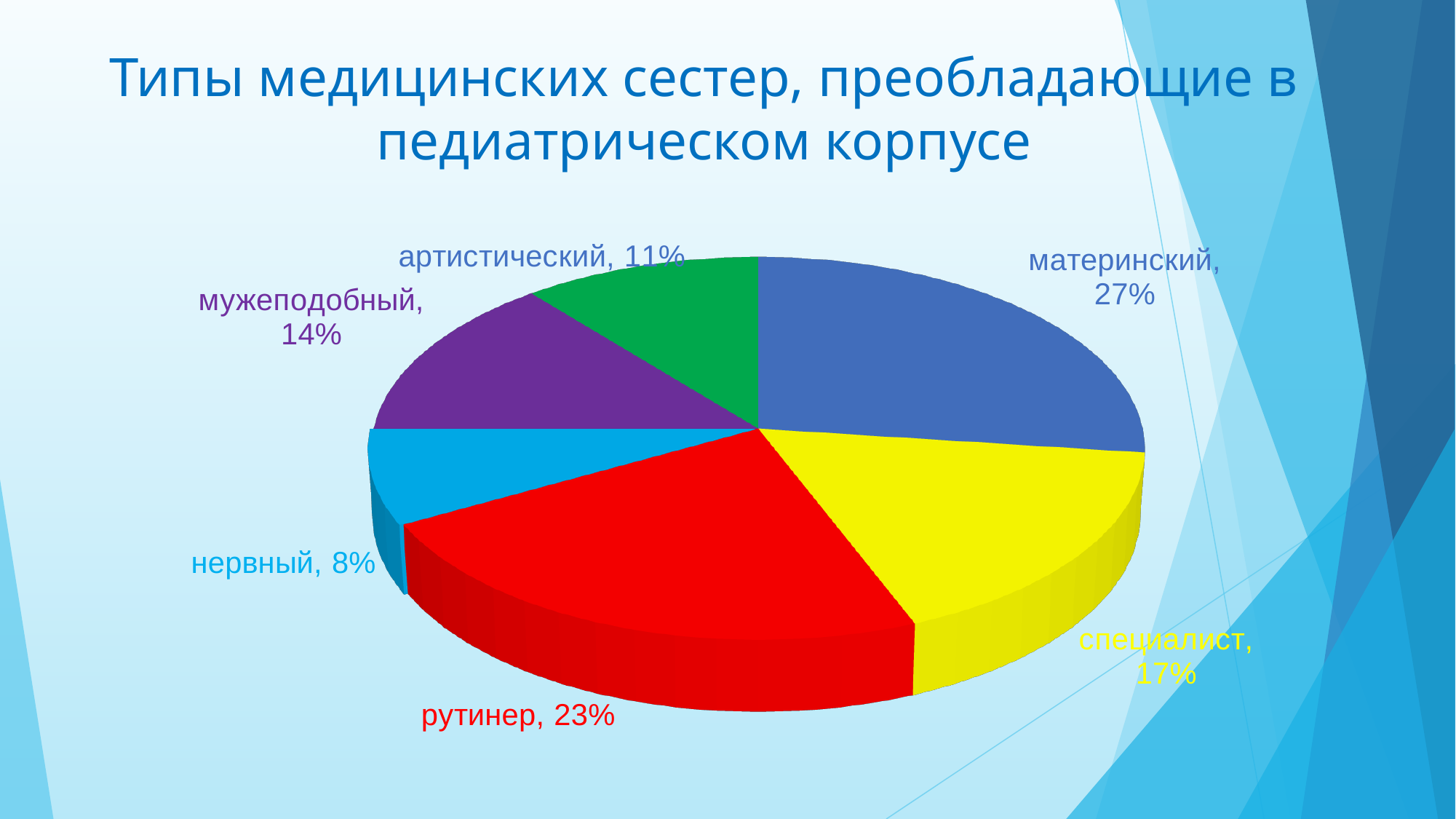
What is the difference in percentage points between материнский and рутинер? 4 What is the combined share of специалист and нервный? 25% How many slices does the pie chart have? 6 What percentage is shown for специалист? 17% Which type of nurse has the largest share of the pie? материнский What colour is the slice for рутинер? red Which is larger, the share for мужеподобный or the share for артистический? мужеподобный What kind of chart is shown on the slide? pie chart What percentage is shown for нервный? 8% What percentage is shown for рутинер? 23% What percentage is shown for материнский? 27% Which type of nurse has the smallest share of the pie? нервный